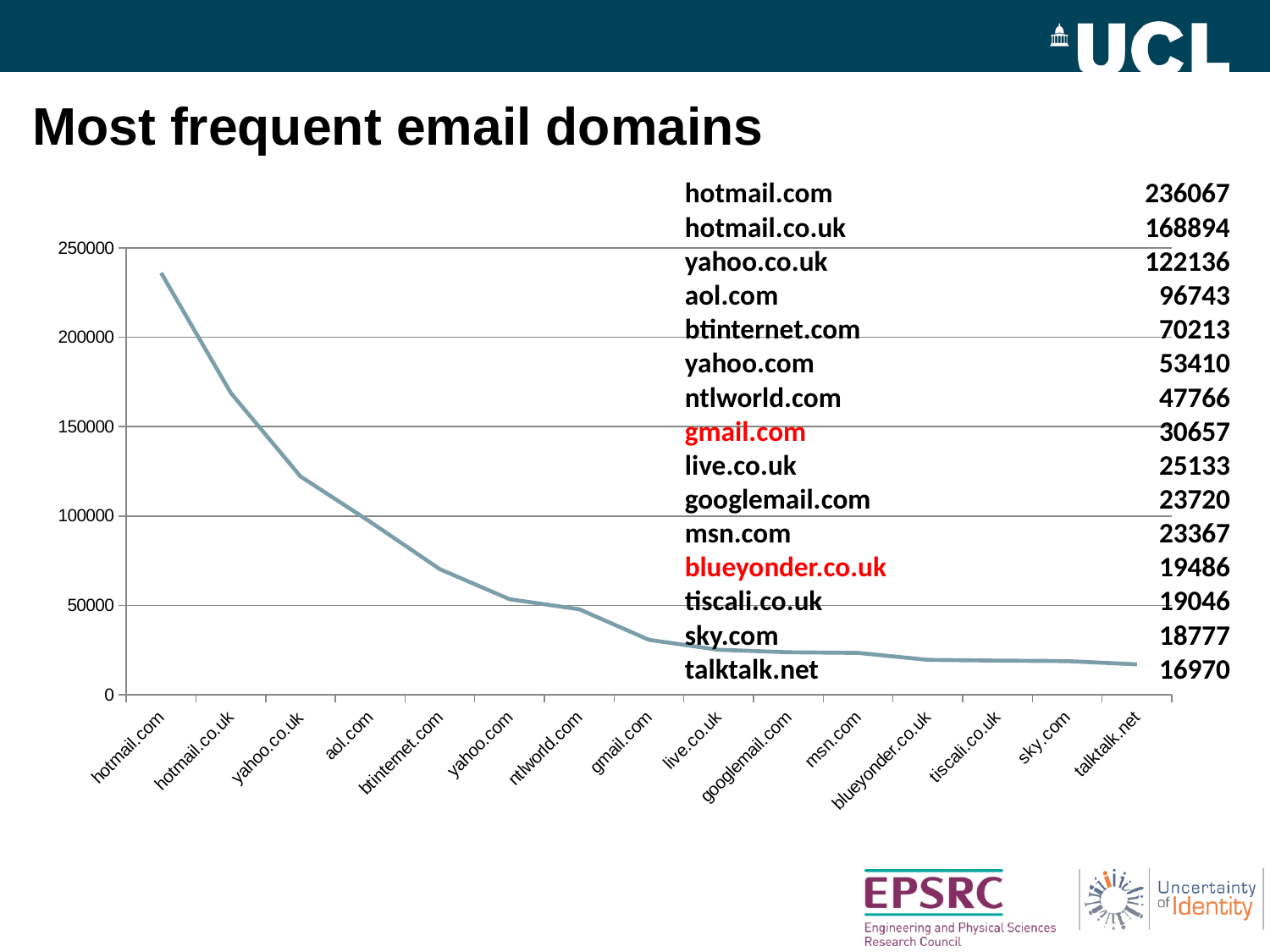
Which email domain has the highest value? hotmail.com What is the value for hotmail.com? 236067 What is the difference between the values for hotmail.com and hotmail.co.uk? 67173 Which email domain has the lowest value? talktalk.net How many email domains are plotted on the chart? 15 Which has a larger value, yahoo.com or ntlworld.com? yahoo.com Is the value for aol.com greater or less than 100000? less Do the values rise or fall from left to right along the x axis? fall What is the value for talktalk.net? 16970 What is the title of the slide? Most frequent email domains What is the value for gmail.com? 30657 What kind of chart is shown on the slide? line chart